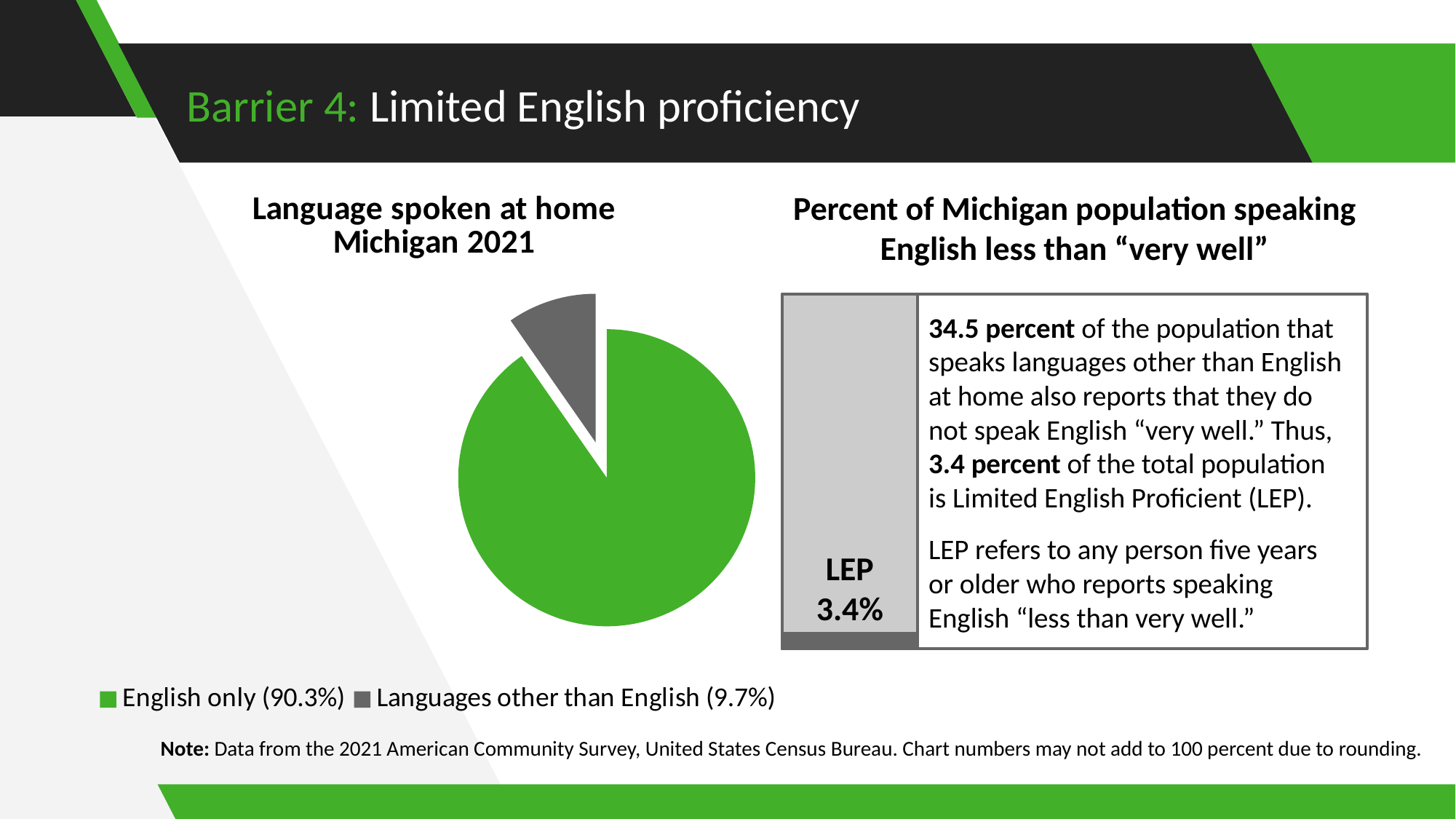
In the "Language spoken at home Michigan 2021" pie chart, what colour is the "English only" slice? Green In the "Language spoken at home Michigan 2021" pie chart, what colour is the "Languages other than English" slice? Grey In the "Language spoken at home Michigan 2021" pie chart, what is the difference in percentage points between the "English only" and "Languages other than English" slices? 80.6 percentage points In the "Language spoken at home Michigan 2021" pie chart, how many slices does the pie have? 2 In the "Language spoken at home Michigan 2021" pie chart, what share of the pie is "Languages other than English"? 9.7% What kind of chart is shown under the title "Language spoken at home Michigan 2021"? Pie chart In the "Language spoken at home Michigan 2021" pie chart, is the share for "Languages other than English" greater or less than 10%? less In the "Language spoken at home Michigan 2021" pie chart, which slice is the largest? English only In the "Language spoken at home Michigan 2021" pie chart, what share of the pie is "English only"? 90.3% In the "Language spoken at home Michigan 2021" pie chart, which is larger: "English only" or "Languages other than English"? English only According to the graphic titled "Percent of Michigan population speaking English less than 'very well'", what percent of the population is LEP? 3.4% In the "Language spoken at home Michigan 2021" pie chart, which slice is the smallest? Languages other than English